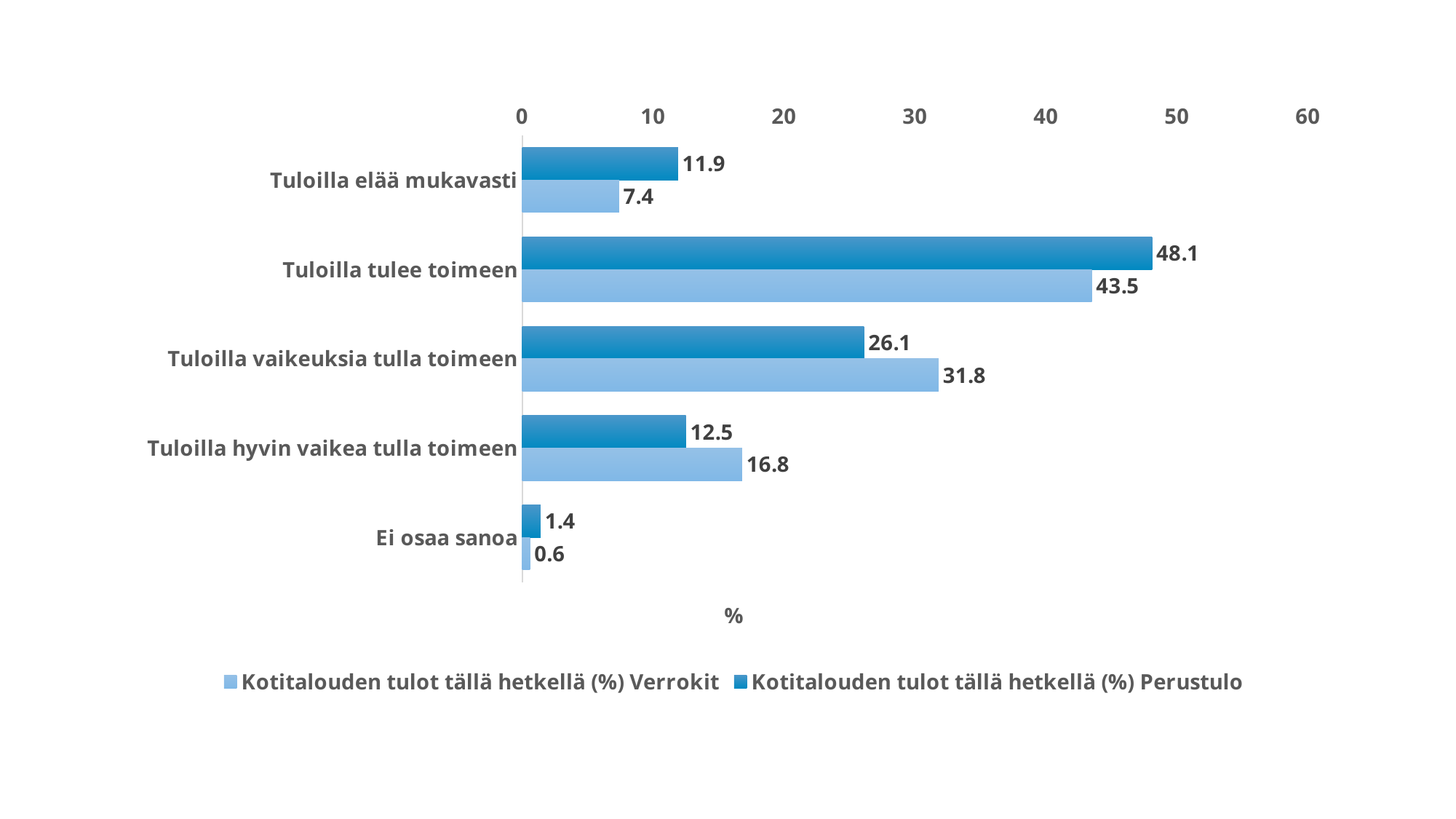
For "Tuloilla elää mukavasti", which series has the larger value, Perustulo or Verrokit? Perustulo How many categories are shown on the chart? 5 What is the difference between the Perustulo and Verrokit values for "Tuloilla hyvin vaikea tulla toimeen"? 4.3 Which category has the lowest Verrokit value? Ei osaa sanoa What is the Verrokit value for "Tuloilla vaikeuksia tulla toimeen"? 31.8 What unit label is shown on the horizontal axis? % How many series does the legend list? 2 What kind of chart is shown on the slide? bar chart What is the Verrokit value for "Ei osaa sanoa"? 0.6 What is the Perustulo value for "Tuloilla tulee toimeen"? 48.1 Which category has the highest Perustulo value? Tuloilla tulee toimeen Is the Verrokit value for "Tuloilla tulee toimeen" greater or less than 40? greater